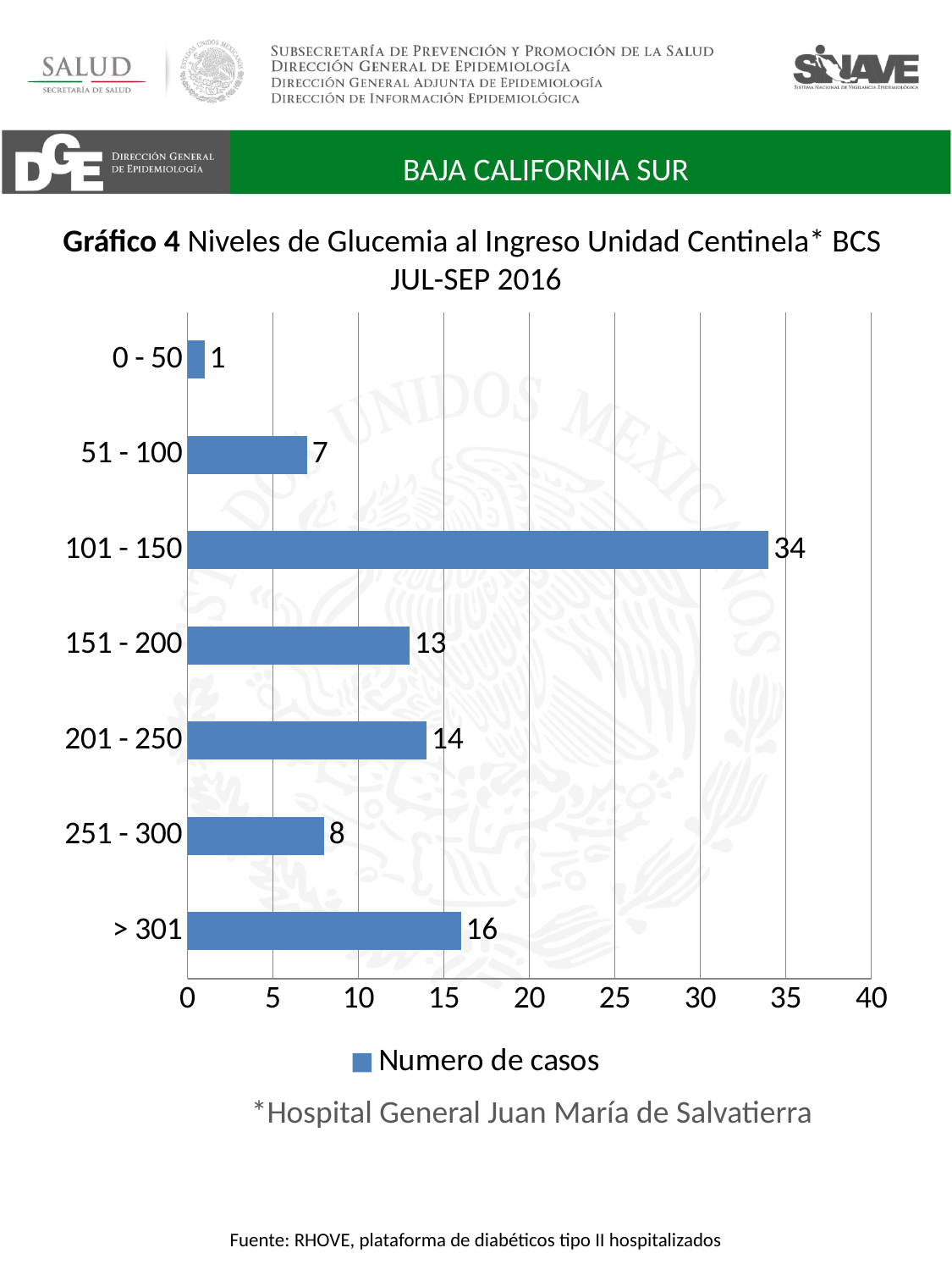
What is the number of cases for the > 301 category? 16 How many series does the legend list? 1 Which glucose level category has the highest number of cases? 101 - 150 What is the number of cases for the 51 - 100 category? 7 How many glucose level categories are shown in the chart? 7 Which category has more cases, 251 - 300 or > 301? > 301 What kind of chart is shown on the slide? Bar chart What is the difference in number of cases between the 101 - 150 and 151 - 200 categories? 21 Which glucose level category has the lowest number of cases? 0 - 50 What is the number of cases for the 101 - 150 glucose level category? 34 What is the series name shown in the legend? Numero de casos What is the difference in number of cases between the 201 - 250 and 0 - 50 categories? 13